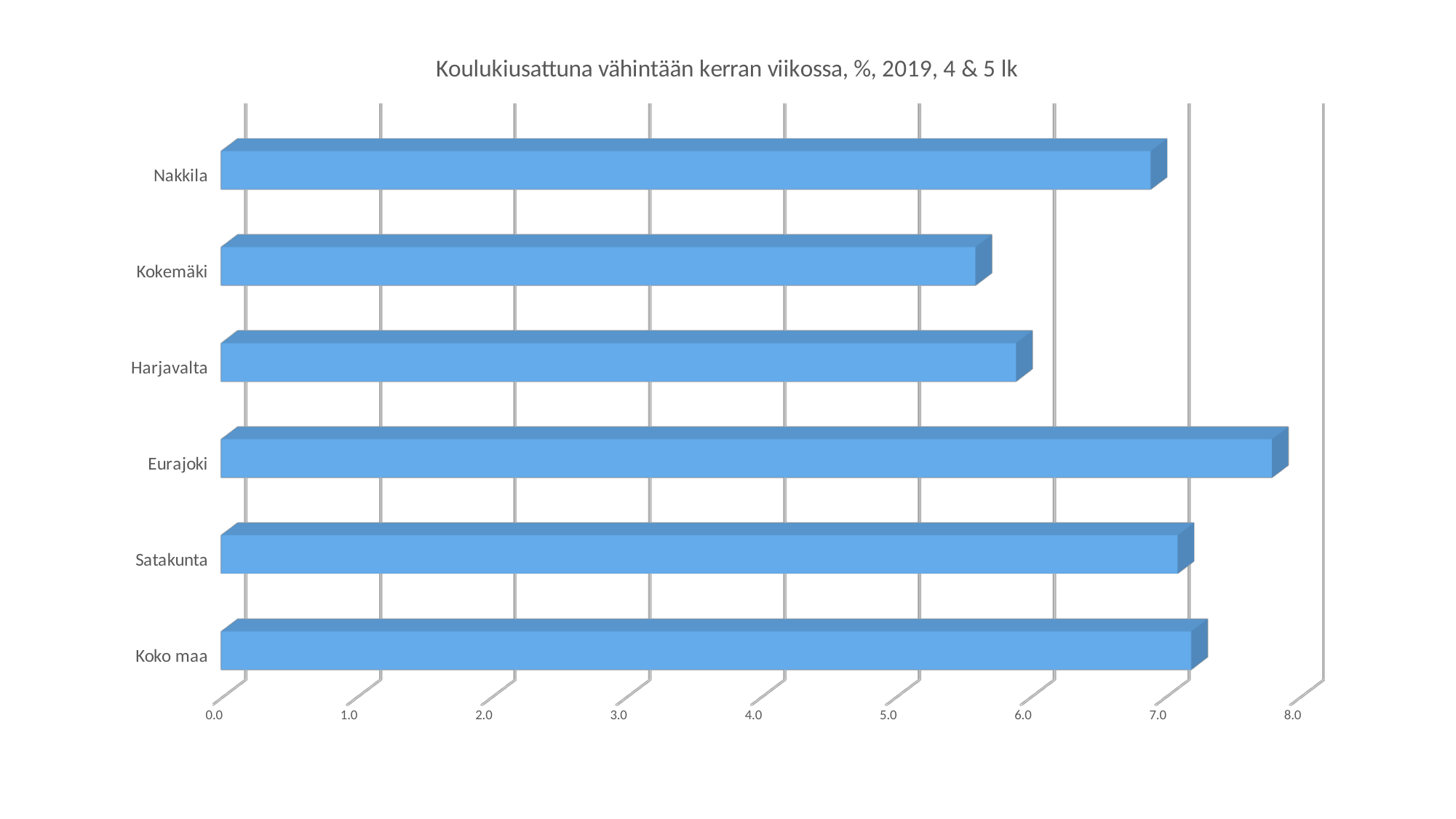
Which category has the highest value? Eurajoki How many categories are shown in the chart? 6 What kind of chart is shown on the slide? bar chart Is the value for Eurajoki greater or less than 8.0? less What is the title of the chart? Koulukiusattuna vähintään kerran viikossa, %, 2019, 4 & 5 lk Is the value for Eurajoki greater or less than 7.0? greater Which has a larger value, Nakkila or Harjavalta? Nakkila Is the value for Kokemäki greater or less than 6.0? less Which has a larger value, Eurajoki or Kokemäki? Eurajoki Which category has the lowest value? Kokemäki